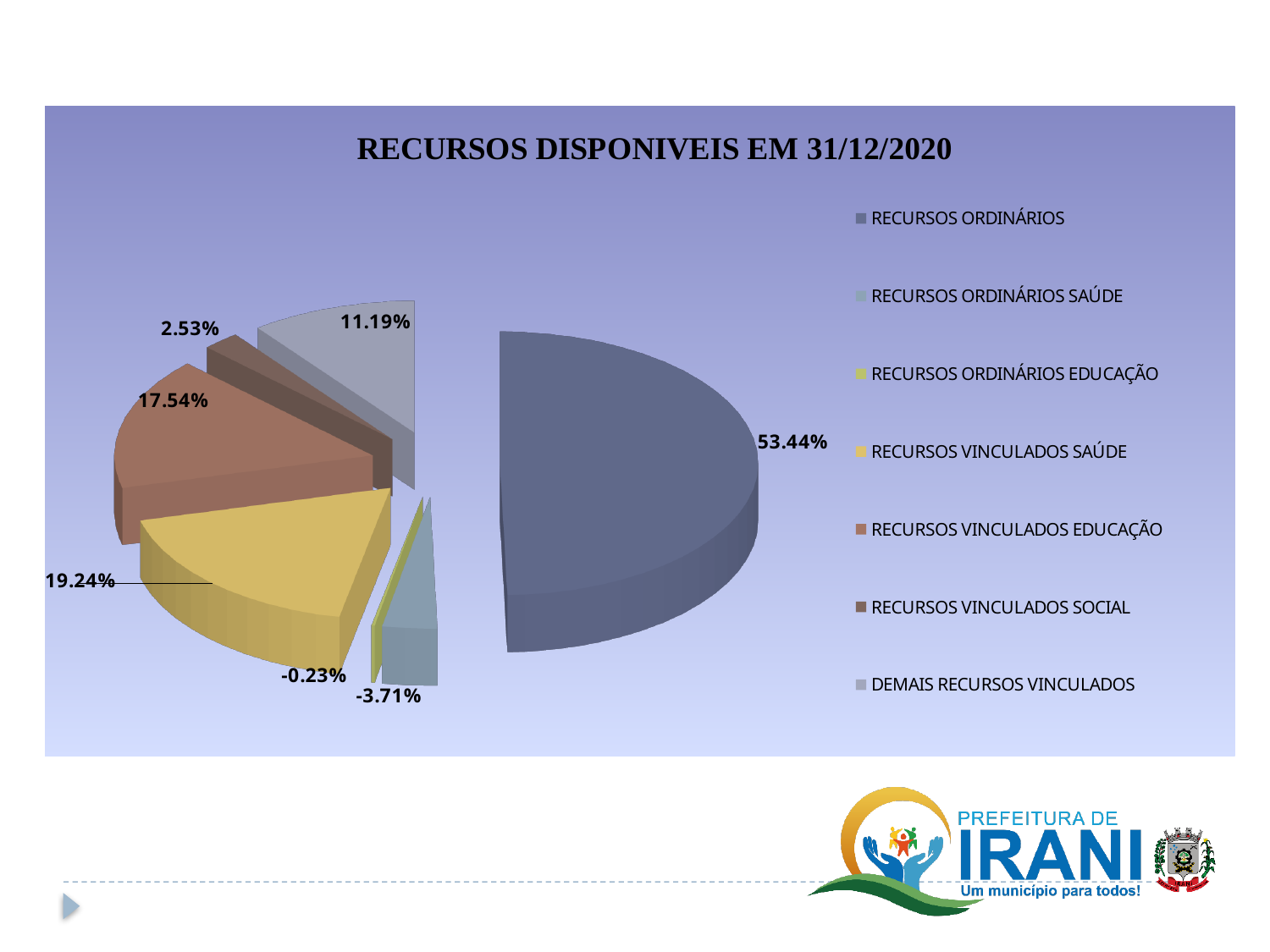
What is the title of the chart? RECURSOS DISPONIVEIS EM 31/12/2020 Which is larger, the share of RECURSOS VINCULADOS EDUCAÇÃO or DEMAIS RECURSOS VINCULADOS? RECURSOS VINCULADOS EDUCAÇÃO What type of chart is shown on the slide? Pie chart What is the difference between the shares of RECURSOS VINCULADOS SAÚDE and RECURSOS VINCULADOS EDUCAÇÃO? 1.70% Which category has the lowest value shown in the pie chart? RECURSOS ORDINÁRIOS SAÚDE What share of the pie is DEMAIS RECURSOS VINCULADOS? 11.19% Which category has the largest share of the pie? RECURSOS ORDINÁRIOS What share of the pie is RECURSOS VINCULADOS EDUCAÇÃO? 17.54% How many entries does the legend list? 7 What share of the pie is RECURSOS ORDINÁRIOS? 53.44% How many slices are labelled in the pie chart? 7